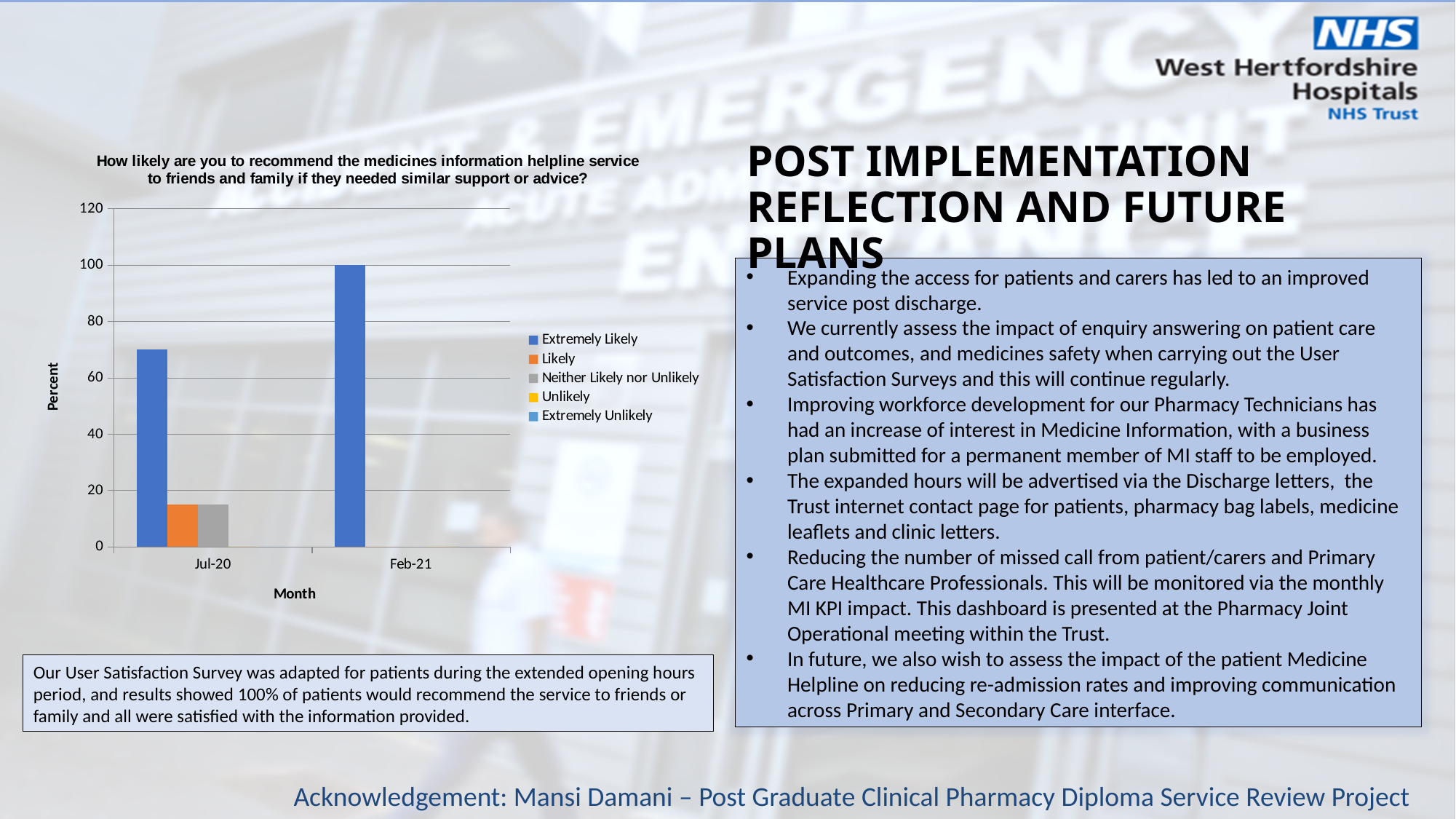
Is the value for Likely in Jul-20 greater or less than 20? less How many series does the chart's legend list? 5 Is the value for Extremely Likely in Jul-20 greater or less than 80? less What is the value for Extremely Likely in Feb-21? 100 Which month has the higher value for Extremely Likely, Jul-20 or Feb-21? Feb-21 Which response category has the highest value in Jul-20? Extremely Likely What is the label on the chart's horizontal axis? Month Does the value for Extremely Likely rise or fall from Jul-20 to Feb-21? rise What kind of chart is shown on the slide? bar chart Is the value for Extremely Likely in Jul-20 greater or less than 60? greater How many months are shown on the x axis of the chart? 2 What is the label on the chart's vertical axis? Percent